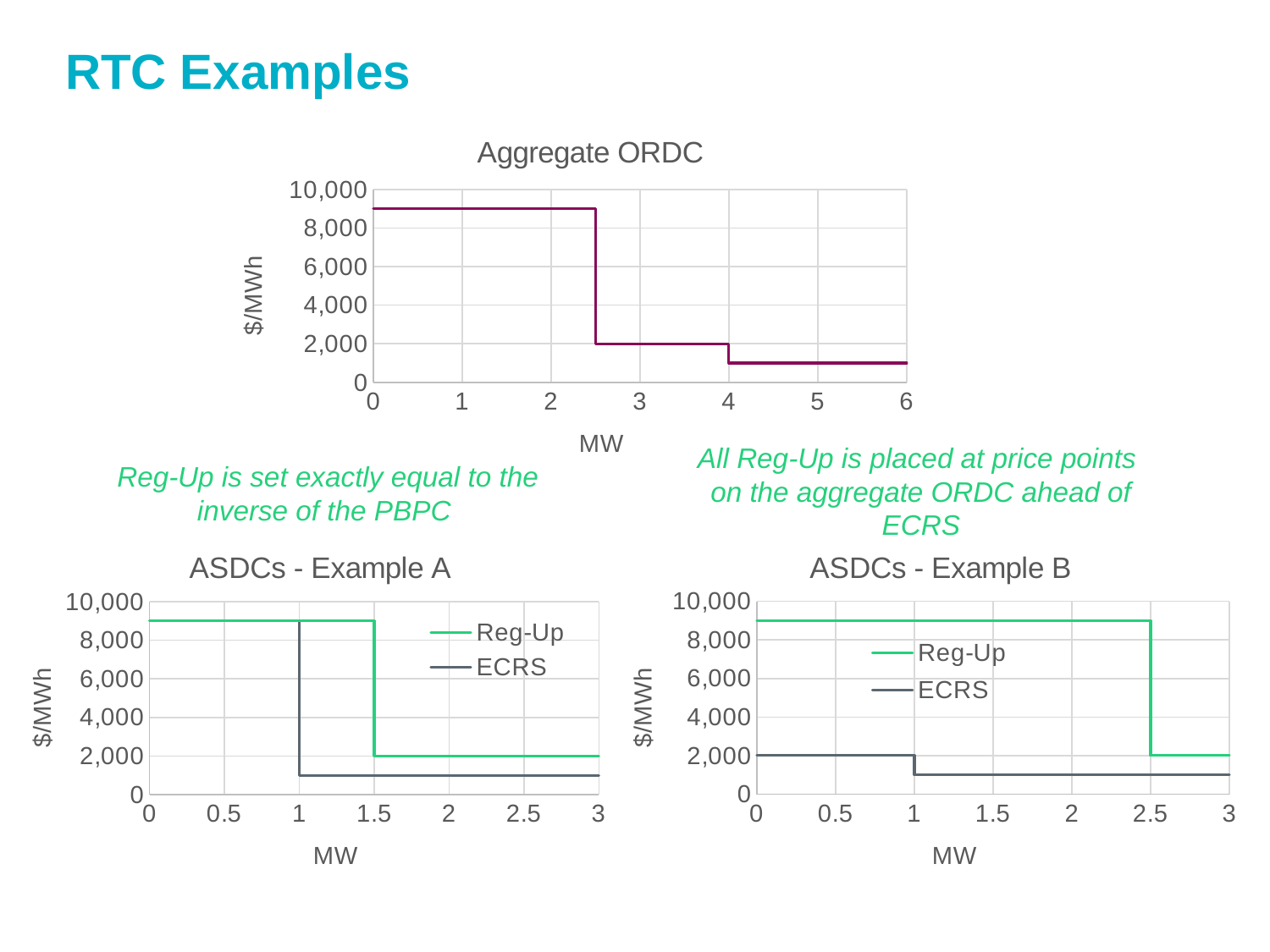
In the Aggregate ORDC chart, is the value at 1 MW greater or less than 8,000? greater In the ASDCs - Example A chart, is the Reg-Up value at 0.5 MW greater or less than 8,000? greater In the Aggregate ORDC chart, do the values rise or fall as MW increases? fall In the ASDCs - Example B chart, what is the ECRS value at 0.5 MW? 2,000 What kind of chart is the Aggregate ORDC chart? line chart In the ASDCs - Example B chart, what are the two legend entries? Reg-Up and ECRS In the Aggregate ORDC chart, what is the $/MWh value at 3 MW? 2,000 In the ASDCs - Example A chart, how many series does the legend list? 2 In the ASDCs - Example B chart, at 2 MW, which series has the larger value, Reg-Up or ECRS? Reg-Up How many charts are shown on the slide? 3